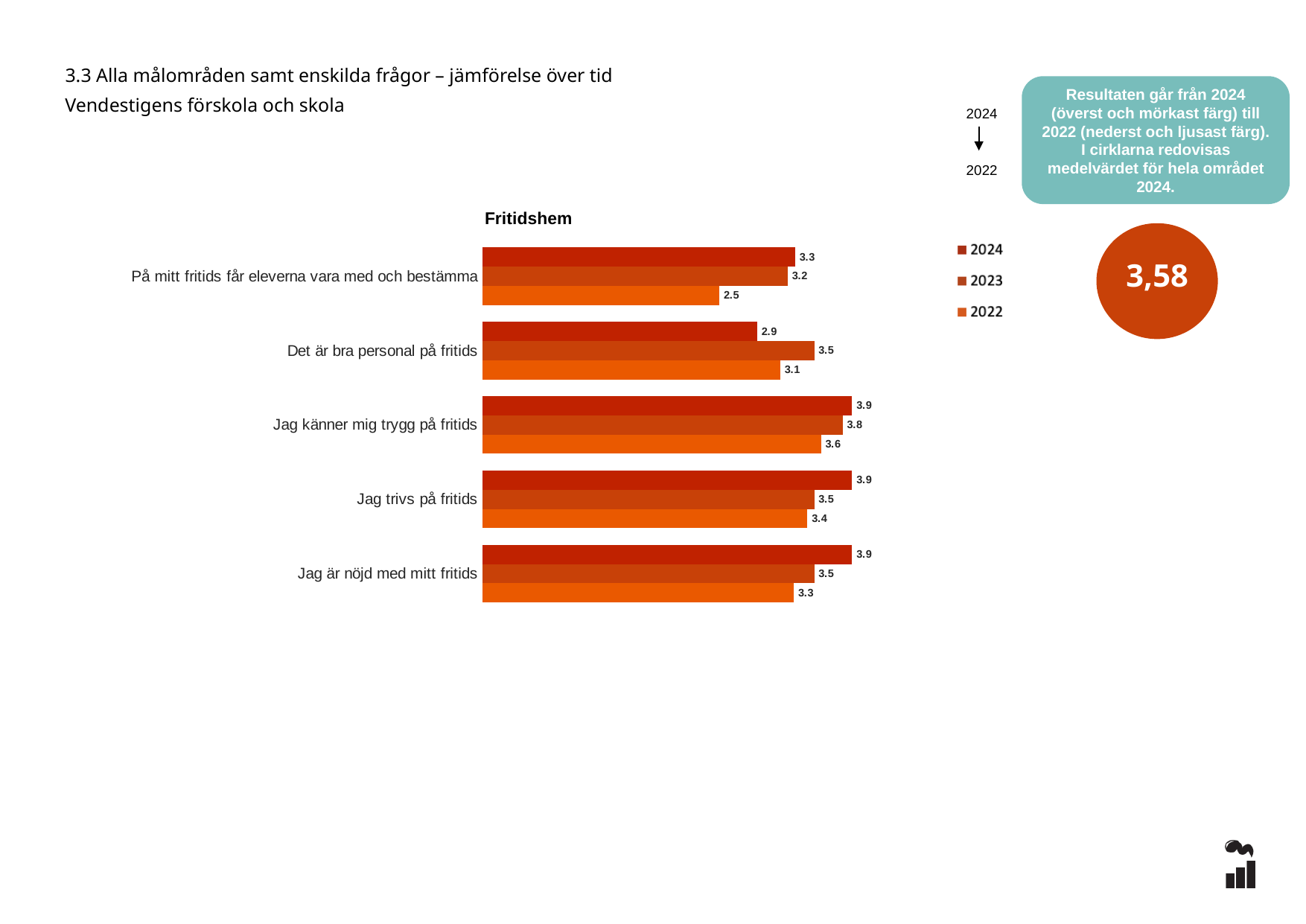
Which category has the lowest 2024 value? Det är bra personal på fritids What is the 2022 value for "Jag är nöjd med mitt fritids"? 3.3 Which category has the lowest 2022 value? På mitt fritids får eleverna vara med och bestämma What is the 2023 value for "Det är bra personal på fritids"? 3.5 What is the difference between the 2023 and 2024 values for "Det är bra personal på fritids"? 0.6 What is the difference between the 2024 and 2022 values for "På mitt fritids får eleverna vara med och bestämma"? 0.8 Which is larger for "Jag trivs på fritids": the 2024 value or the 2022 value? 2024 What is the 2024 value for "Jag känner mig trygg på fritids"? 3.9 What is the 2022 value for "På mitt fritids får eleverna vara med och bestämma"? 2.5 What type of chart is shown on the slide? Bar chart How many categories (questions) are shown in the chart? 5 How many series does the legend list? 3